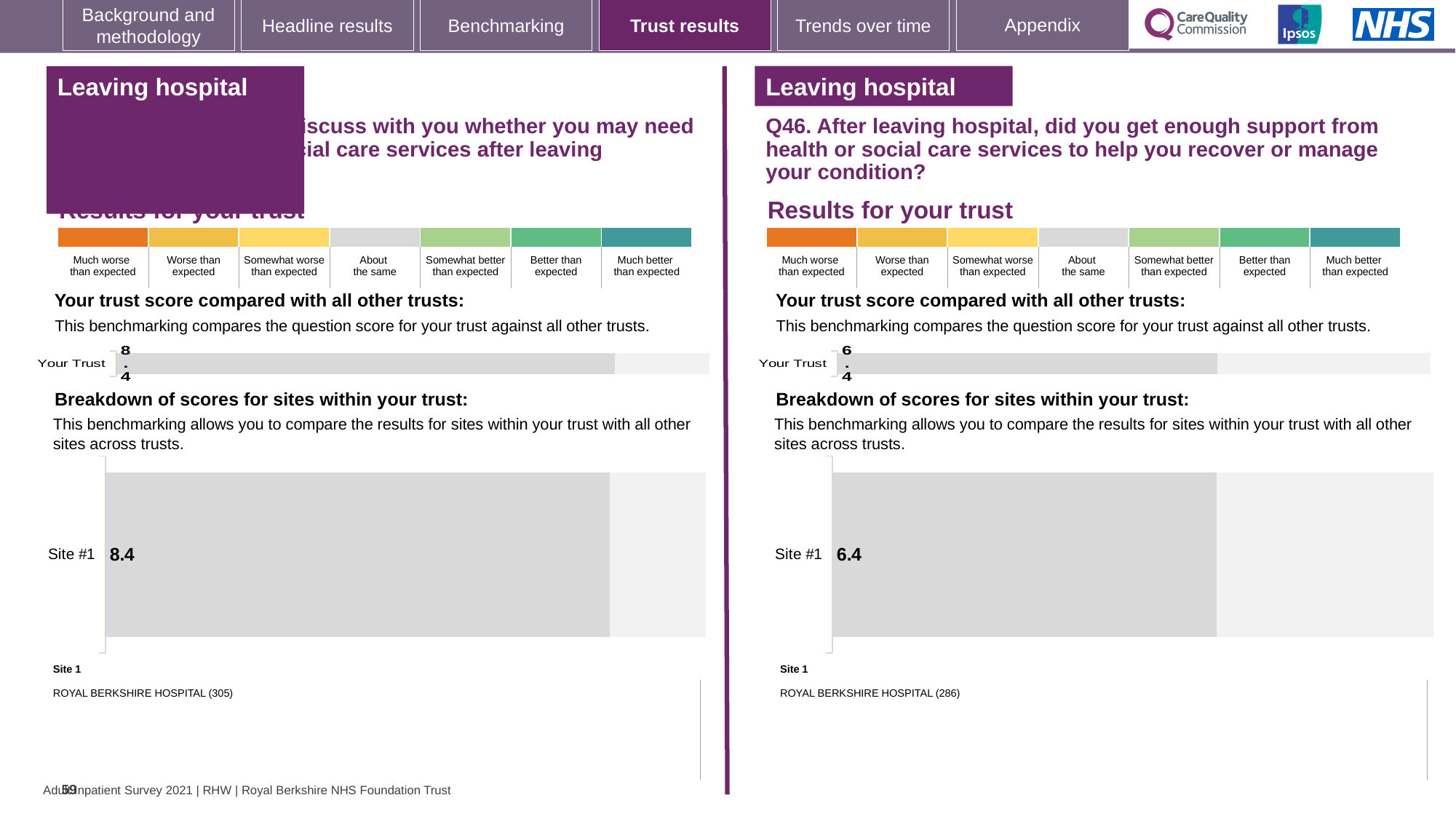
On the left-hand chart, what is the score shown for Site #1? 8.4 How many sites are shown in the site breakdown chart on the right-hand panel for Q46? 1 On the left-hand panel, what is the 'Your Trust' score shown in the trust benchmarking bar? 8.4 On the right-hand chart for Q46, what is the score shown for Site #1? 6.4 What is the difference between the Site #1 score on the left-hand chart and the Site #1 score on the right-hand chart for Q46? 2.0 On the right-hand panel for Q46, which hospital is listed as Site 1? ROYAL BERKSHIRE HOSPITAL (286) Which panel shows the higher Site #1 score, the left-hand chart or the right-hand chart for Q46? the left-hand chart How many categories are shown in the colour scale key on the right-hand panel, from 'Much worse than expected' to 'Much better than expected'? 7 What kind of chart is used for the site breakdown on the left-hand panel? bar chart On the left-hand panel, which hospital is listed as Site 1? ROYAL BERKSHIRE HOSPITAL (305) On the right-hand panel for Q46, what is the 'Your Trust' score shown in the trust benchmarking bar? 6.4